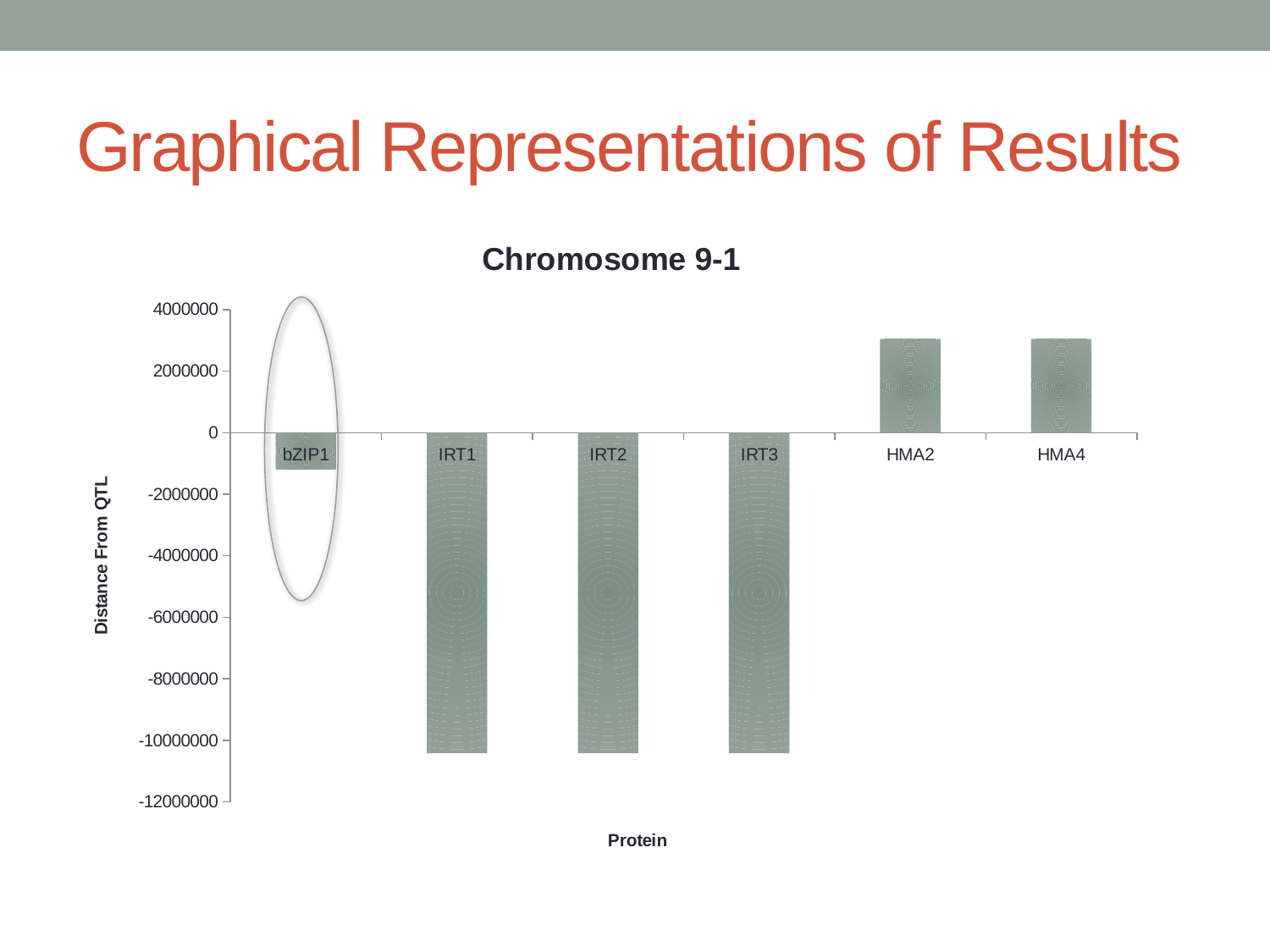
How many proteins are plotted on the x axis of the chart? 6 What is the label of the y axis of the chart? Distance From QTL Is the value for HMA4 greater or less than 4000000? less Which has the larger value, bZIP1 or IRT1? bZIP1 Which has the larger value, HMA2 or IRT2? HMA2 Is the value for bZIP1 greater or less than -2000000? greater Is the value for IRT1 greater or less than -10000000? less What is the title of the chart? Chromosome 9-1 How many bars in the chart have negative values? 4 What kind of chart is shown on the slide? bar chart